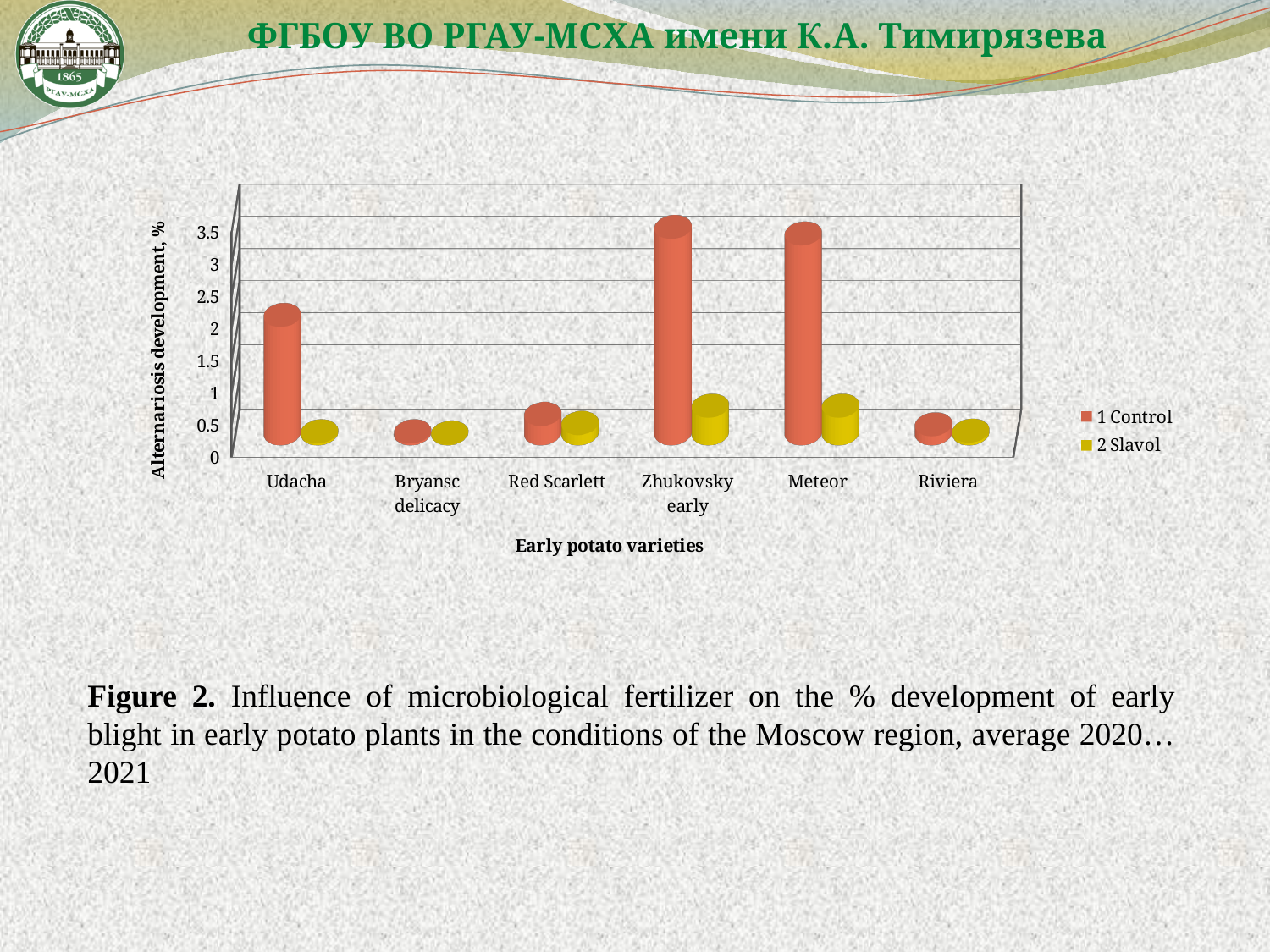
Is the 1 Control value for Bryansc delicacy greater or less than 1? less What are the two series named in the chart legend? 1 Control and 2 Slavol Is the 1 Control value for Zhukovsky early greater or less than 3? greater Is the 1 Control value for Meteor greater or less than 3? greater What is the title of the vertical axis of the chart? Alternariosis development, % What kind of chart is shown on the slide? bar chart Which variety has the larger 1 Control value, Zhukovsky early or Riviera? Zhukovsky early For Udacha, which series has the larger value, 1 Control or 2 Slavol? 1 Control How many series does the chart legend list? 2 How many early potato varieties are shown on the x axis of the chart? 6